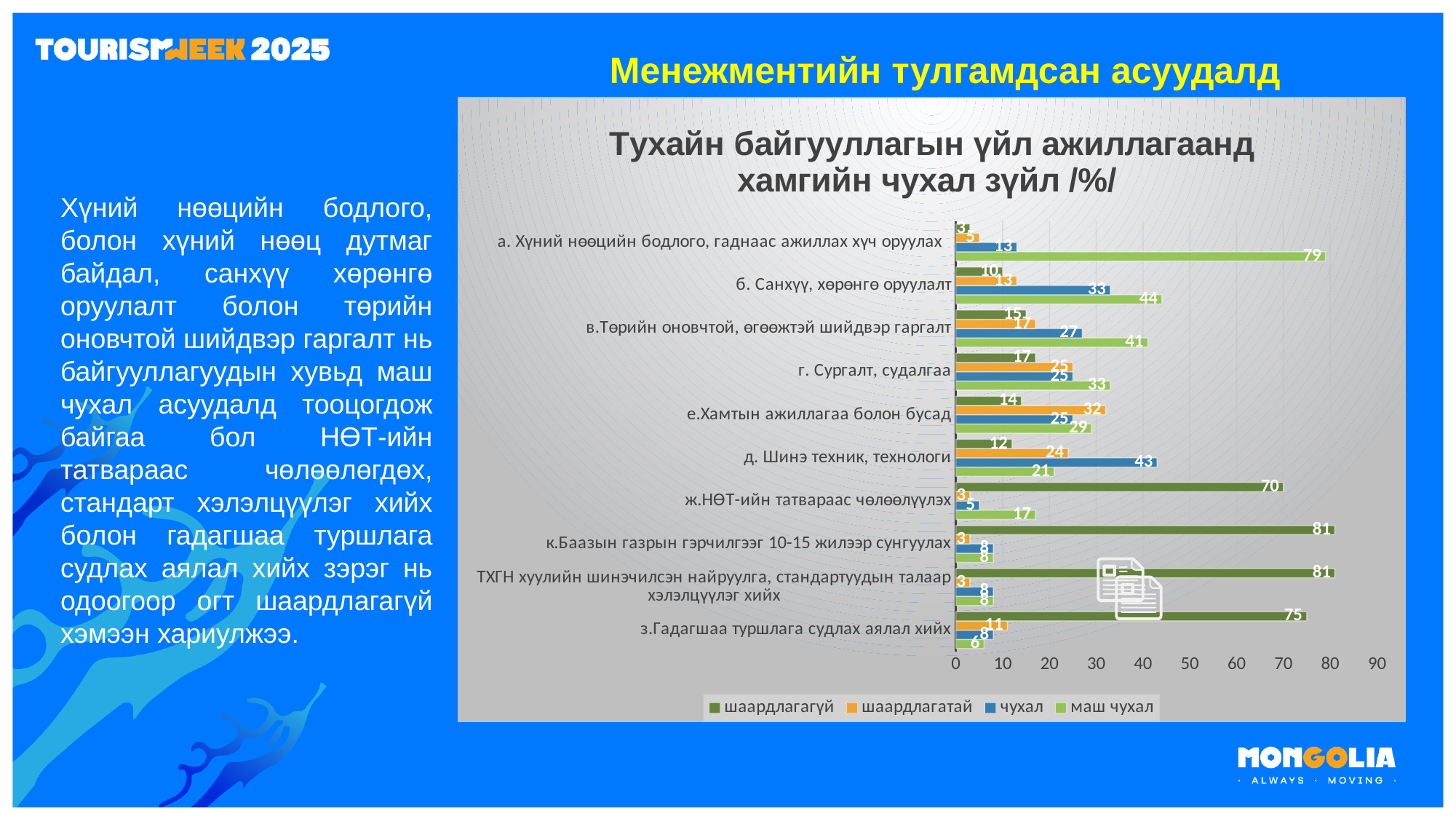
What is the value of "шаардлагагүй" for "ж.НӨТ-ийн татвараас чөлөөлүүлэх"? 70 What is the value of "маш чухал" for "а. Хүний нөөцийн бодлого, гаднаас ажиллах хүч оруулах"? 79 Which category has the lowest "шаардлагагүй" value? а. Хүний нөөцийн бодлого, гаднаас ажиллах хүч оруулах What is the title of the chart? Тухайн байгууллагын үйл ажиллагаанд хамгийн чухал зүйл /%/ What is the value of "чухал" for "д. Шинэ техник, технологи"? 43 Which category has the highest "маш чухал" value? а. Хүний нөөцийн бодлого, гаднаас ажиллах хүч оруулах What is the value of "шаардлагатай" for "е.Хамтын ажиллагаа болон бусад"? 32 How many categories are shown on the chart? 10 Which is larger for "з.Гадагшаа туршлага судлах аялал хийх": "шаардлагатай" or "чухал"? шаардлагатай What kind of chart is shown on the slide? bar chart What is the difference between the "маш чухал" values for "б. Санхүү, хөрөнгө оруулалт" and "в.Төрийн оновчтой, өгөөжтэй шийдвэр гаргалт"? 3 How many series does the legend list? 4